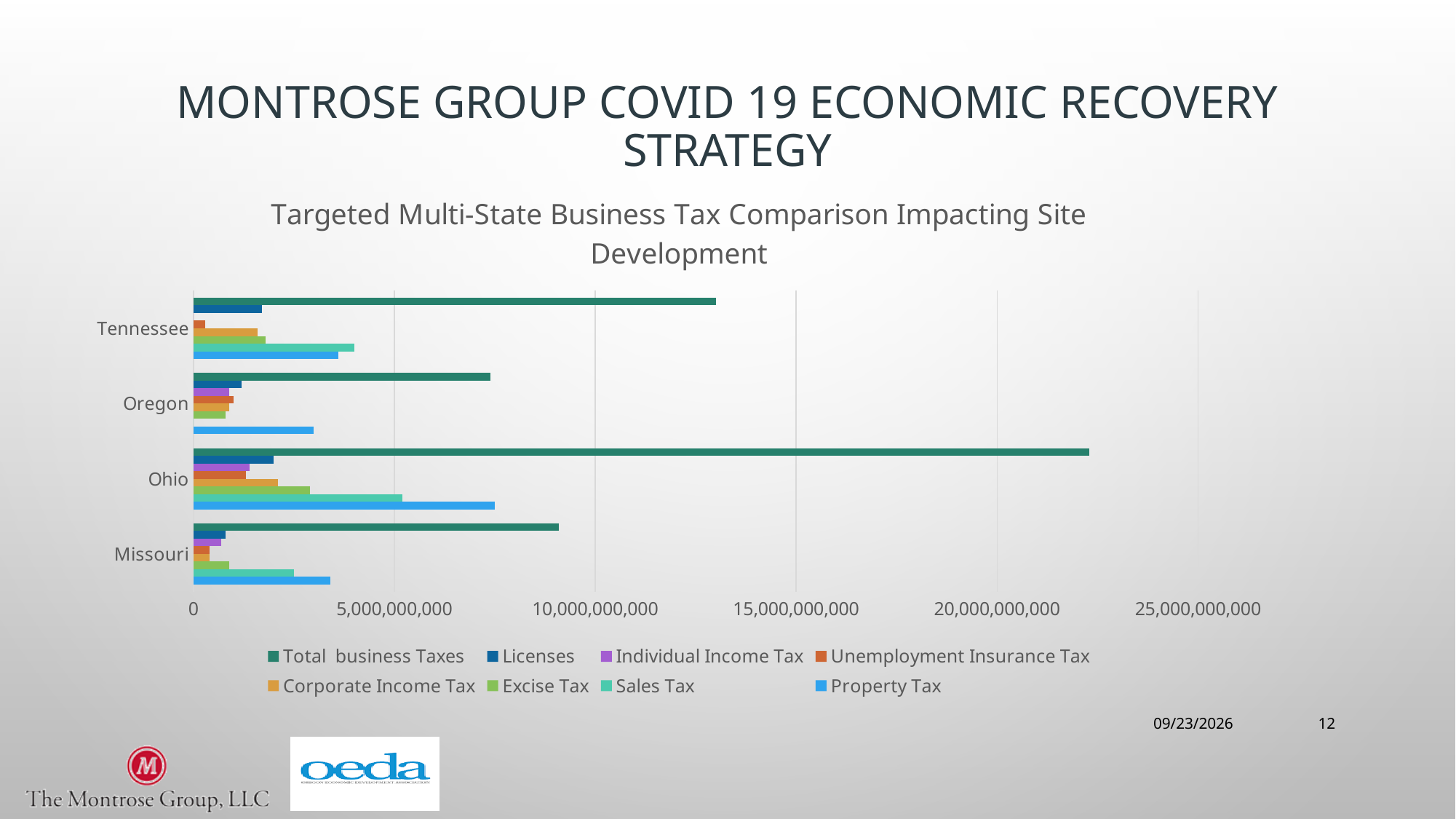
Which state has the lowest Total business Taxes? Oregon How many states are shown on the chart? 4 What is the title of the chart? Targeted Multi-State Business Tax Comparison Impacting Site Development Is the Property Tax value for Ohio greater or less than 5,000,000,000? greater Is the Total business Taxes value for Ohio greater or less than 20,000,000,000? greater Which state has a larger Property Tax value, Ohio or Oregon? Ohio How many series does the legend list? 8 What kind of chart is shown on the slide? bar chart Is the Total business Taxes value for Oregon greater or less than 10,000,000,000? less Which state has the highest Total business Taxes? Ohio Which state has larger Total business Taxes, Tennessee or Missouri? Tennessee